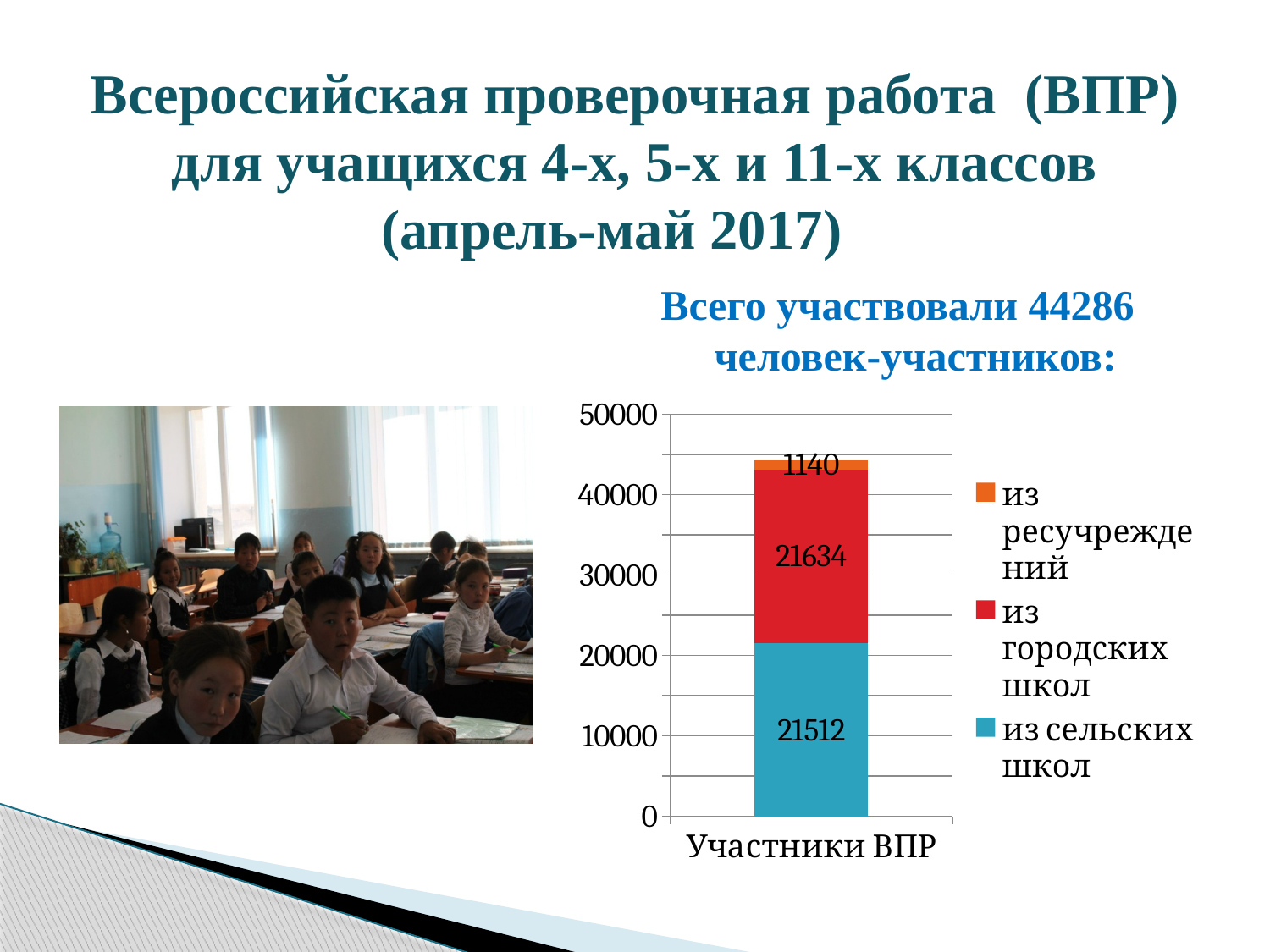
What is the value for "из городских школ" in the chart? 21634 What is the total of the stacked bar for "Участники ВПР"? 44286 What is the difference between the values for "из городских школ" and "из сельских школ"? 122 What is the label of the category on the x axis of the chart? Участники ВПР How many categories are shown on the x axis of the chart? 1 Which series has the smallest value in the chart? из ресучреждений What is the value for "из ресучреждений" in the chart? 1140 What kind of chart is shown on the slide? stacked bar chart What is the difference between the values for "из сельских школ" and "из ресучреждений"? 20372 How many series does the chart legend list? 3 Is the total height of the stacked bar greater or less than 40000? greater What is the value for "из сельских школ" in the chart? 21512